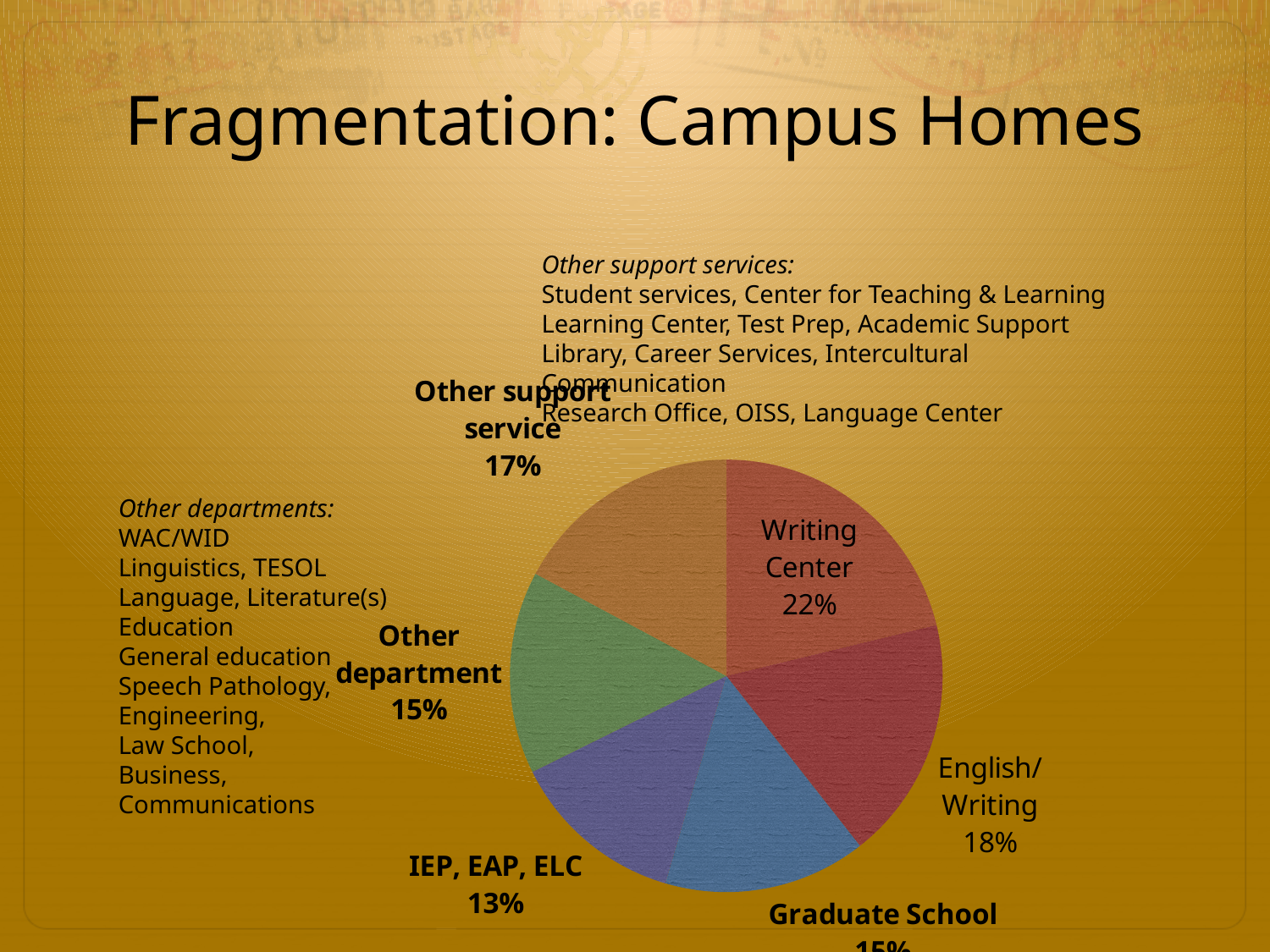
What is the title of the slide containing the pie chart? Fragmentation: Campus Homes Which is larger, the Other support service slice or the Other department slice? Other support service What share of the pie does the Writing Center slice represent? 22% How many percentage points larger is the Writing Center slice than the English/Writing slice? 4 percentage points What percentage is shown for Other support service? 17% Which slice of the pie is the smallest? IEP, EAP, ELC What percentage is shown for IEP, EAP, ELC? 13% Which slice of the pie is the largest? Writing Center What percentage is shown for English/Writing? 18% What percentage is shown for Other department? 15% How many slices does the pie chart have? 6 What kind of chart is shown on the slide? pie chart